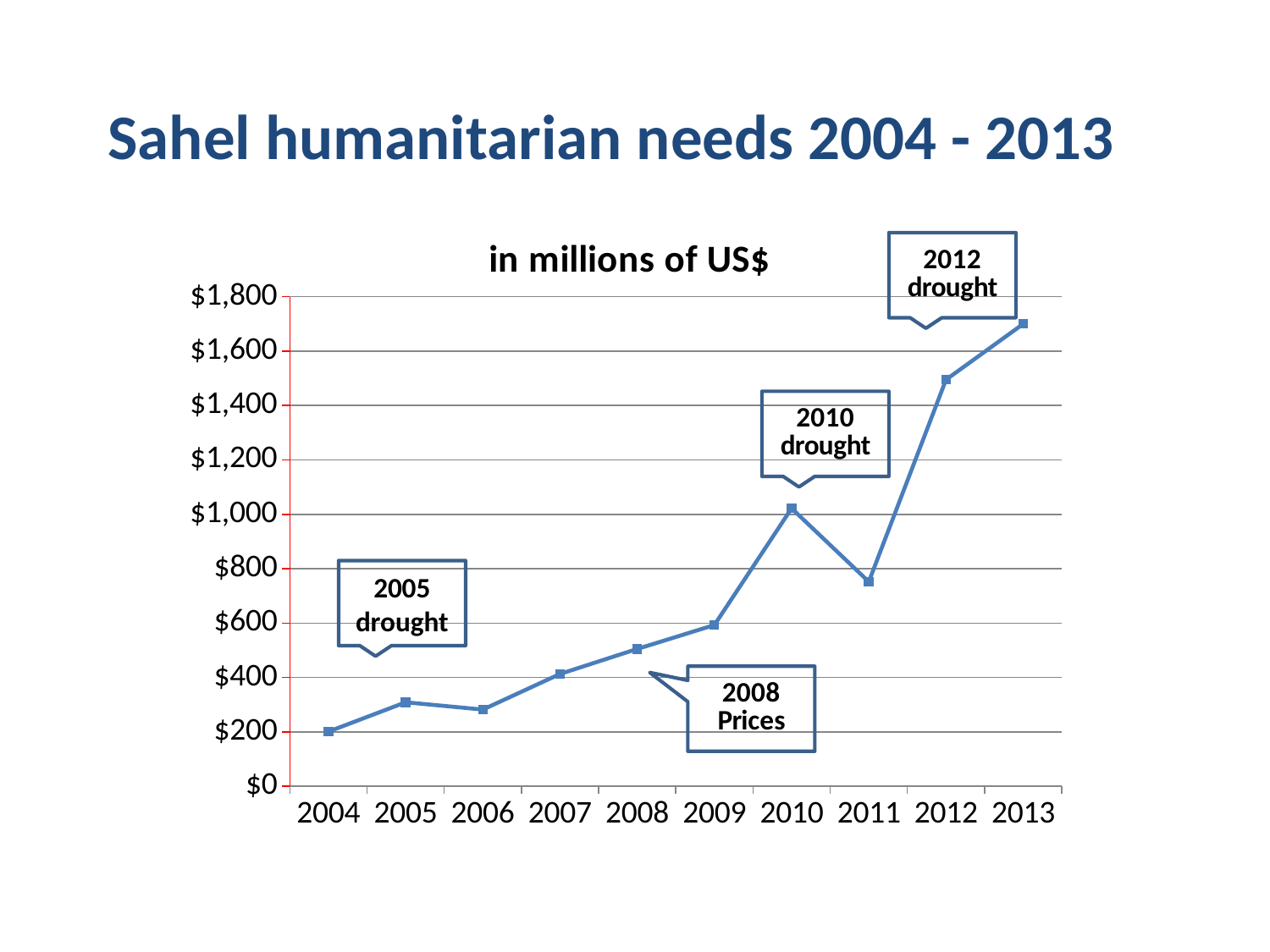
Which year has the highest humanitarian needs value in the chart? 2013 Is the value for 2012 greater or less than $1,400? greater What kind of chart is shown on the slide? line chart Is the value for 2010 greater or less than $800? greater Overall, do the values rise or fall from 2004 to 2013? rise Is the value for 2011 greater or less than $800? less Which year has the lowest humanitarian needs value in the chart? 2004 What unit does the chart's subtitle say the values are in? in millions of US$ How many years are plotted on the x axis of the chart? 10 Which year has the larger value, 2010 or 2011? 2010